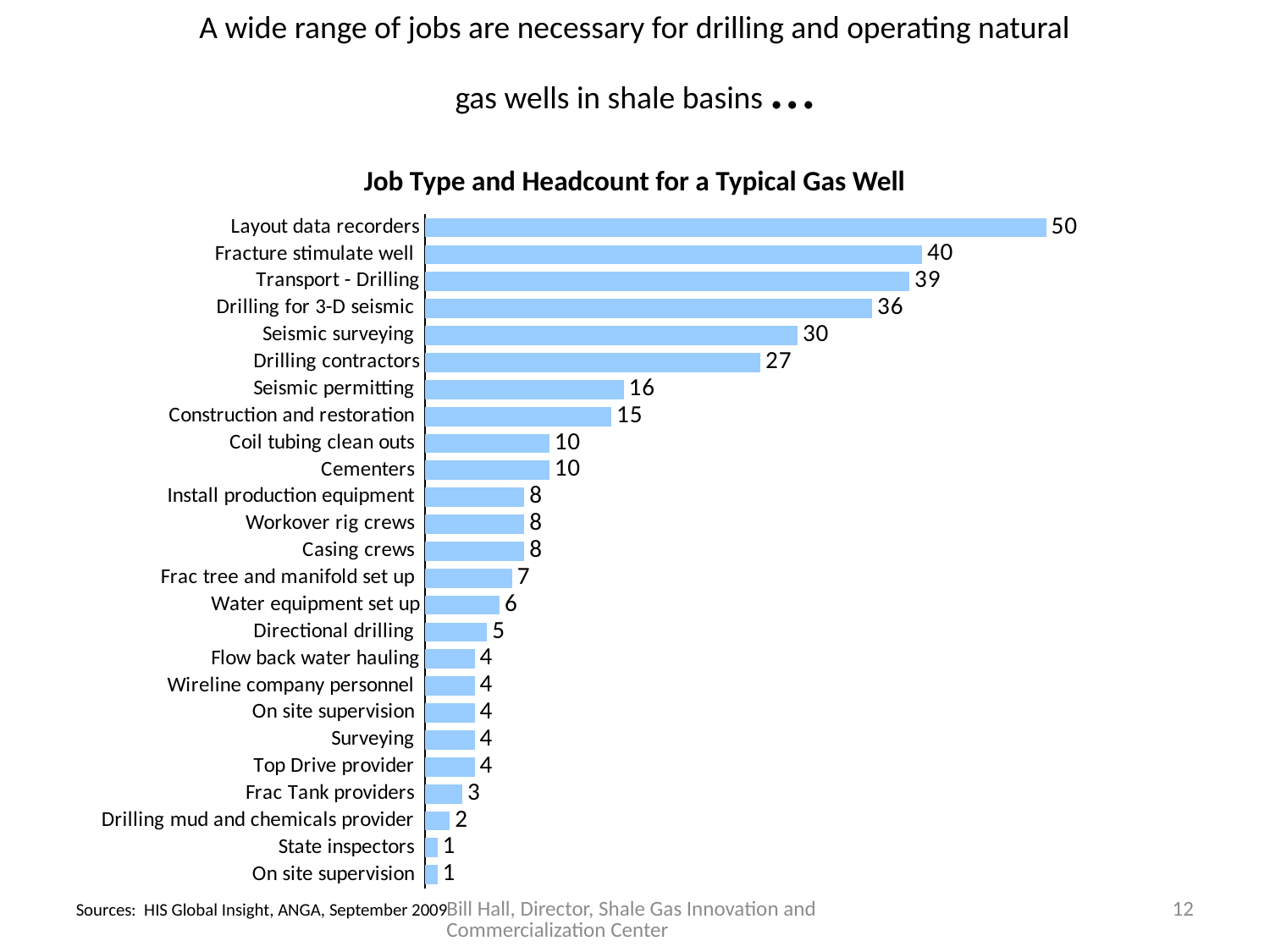
What is the difference in headcount between Layout data recorders and Seismic surveying? 20 What is the headcount for Drilling contractors? 27 Which has a larger headcount, Drilling for 3-D seismic or Construction and restoration? Drilling for 3-D seismic What kind of chart is shown on the slide? Bar chart Which job type has the highest headcount? Layout data recorders What is the difference in headcount between Fracture stimulate well and Transport - Drilling? 1 How many job types are listed on the chart? 25 What is the headcount for Seismic permitting? 16 What is the lowest headcount shown on the chart? 1 What is the headcount for Frac Tank providers? 3 What is the headcount for Layout data recorders? 50 What is the title of the chart? Job Type and Headcount for a Typical Gas Well